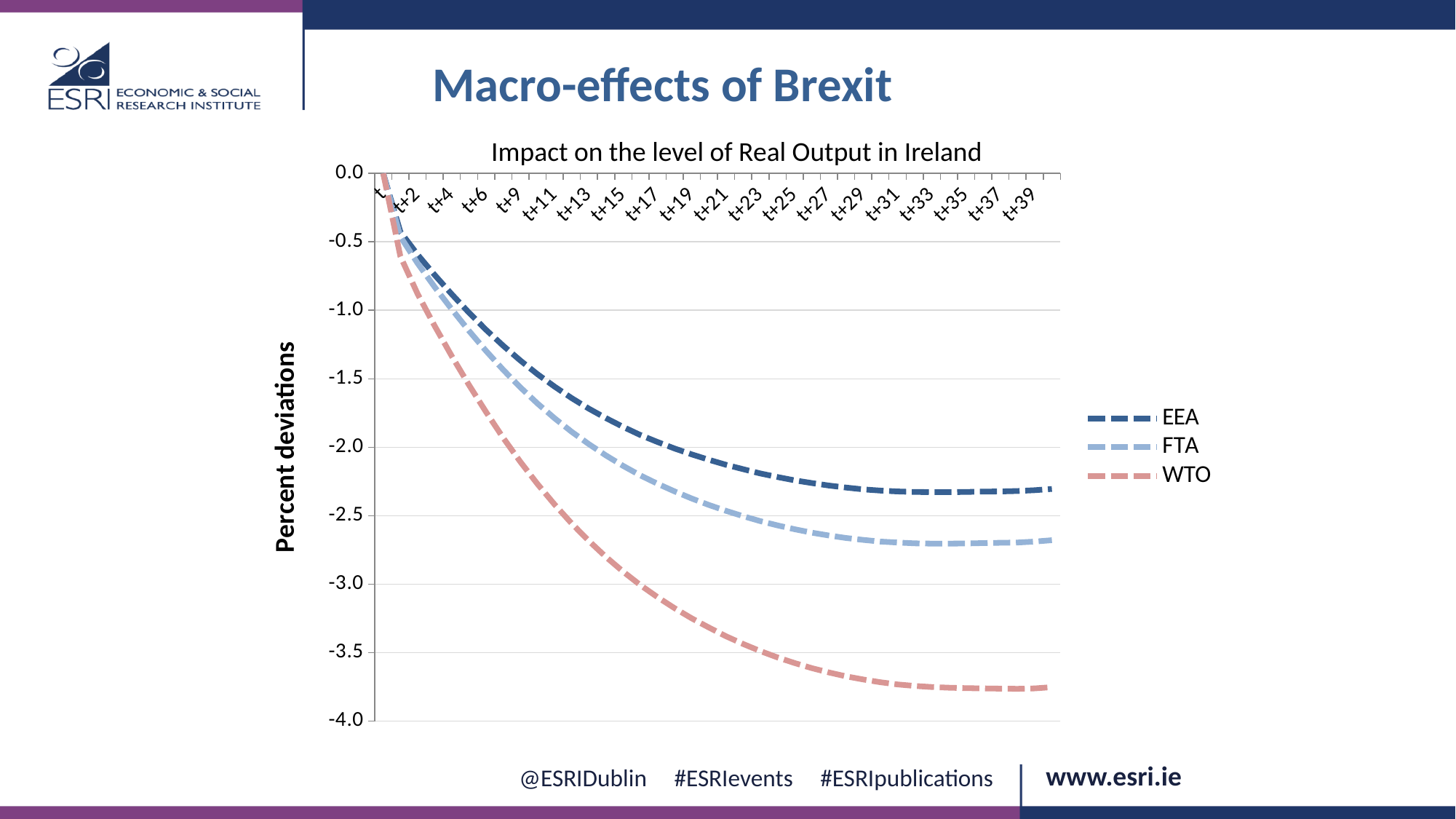
What is the title of the chart? Impact on the level of Real Output in Ireland Is the value for FTA at t+39 greater or less than -2.5? less What are the three series listed in the legend? EEA, FTA, WTO What kind of chart is shown on the slide? line chart Is the value for EEA at t+39 greater or less than -2.5? greater Which series shows the largest negative deviation at t+39? WTO Do the values for the WTO series rise or fall as you move along the x axis from t to t+39? fall How many series does the legend list? 3 Is the value for FTA at t+19 greater or less than -2.0? less At t+39, which is larger, the value for EEA or the value for WTO? EEA Which series shows the smallest negative deviation at t+39? EEA